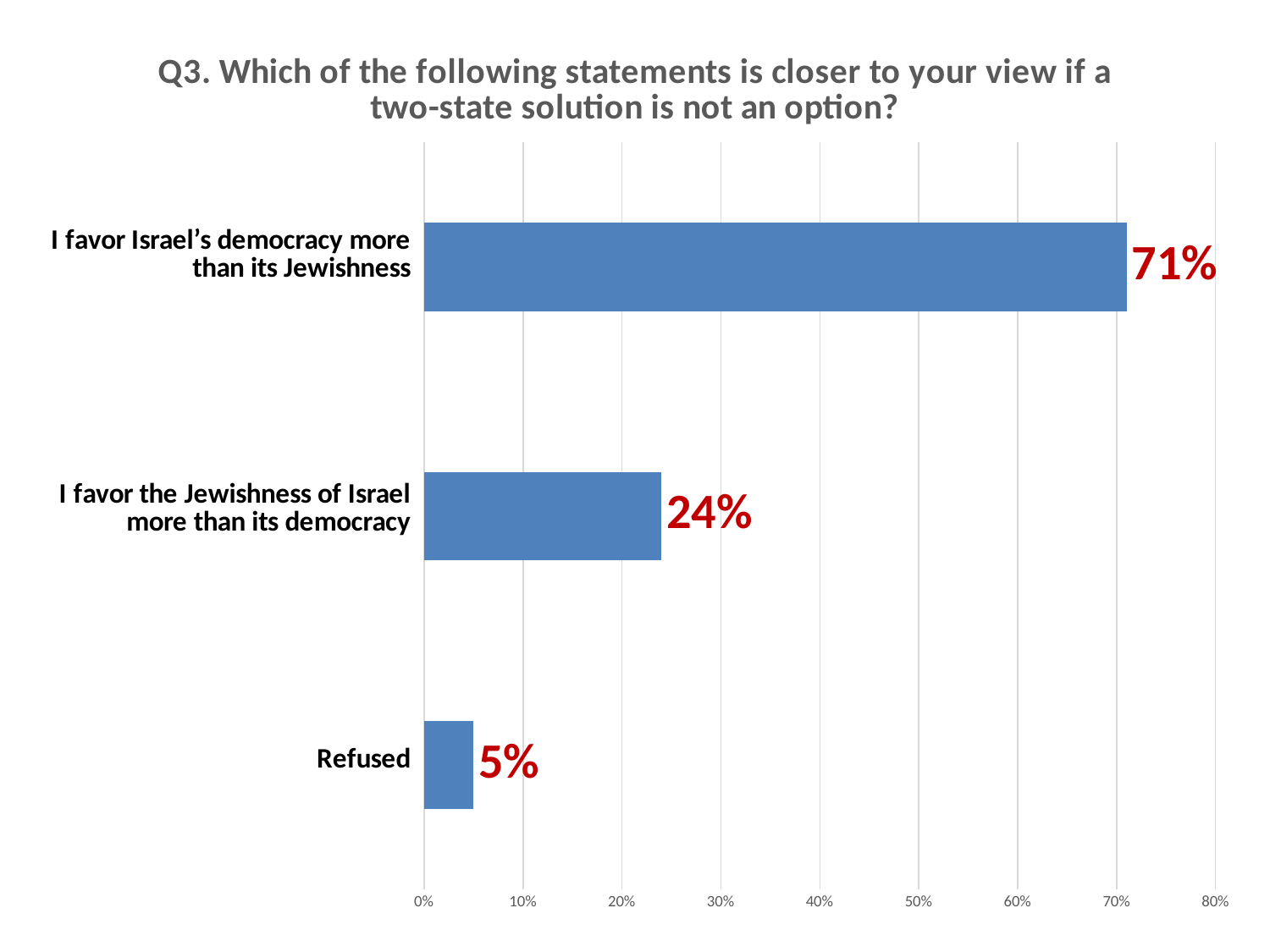
What is the maximum value shown on the horizontal axis? 80% What type of chart is shown on the slide? Bar chart Is the value for 'I favor Israel's democracy more than its Jewishness' greater or less than 70%? greater Which response category has the highest value? I favor Israel's democracy more than its Jewishness Is the value for 'Refused' greater or less than 10%? less What percentage of respondents said they favor Israel's democracy more than its Jewishness? 71% What percentage of respondents said they favor the Jewishness of Israel more than its democracy? 24% What is the difference in percentage points between those favoring democracy over Jewishness and those favoring Jewishness over democracy? 47 percentage points Which is larger: the share favoring the Jewishness of Israel more than its democracy, or the share that refused? I favor the Jewishness of Israel more than its democracy How many response categories are shown in the chart? 3 What percentage of respondents refused to answer? 5% Which response category has the lowest value? Refused